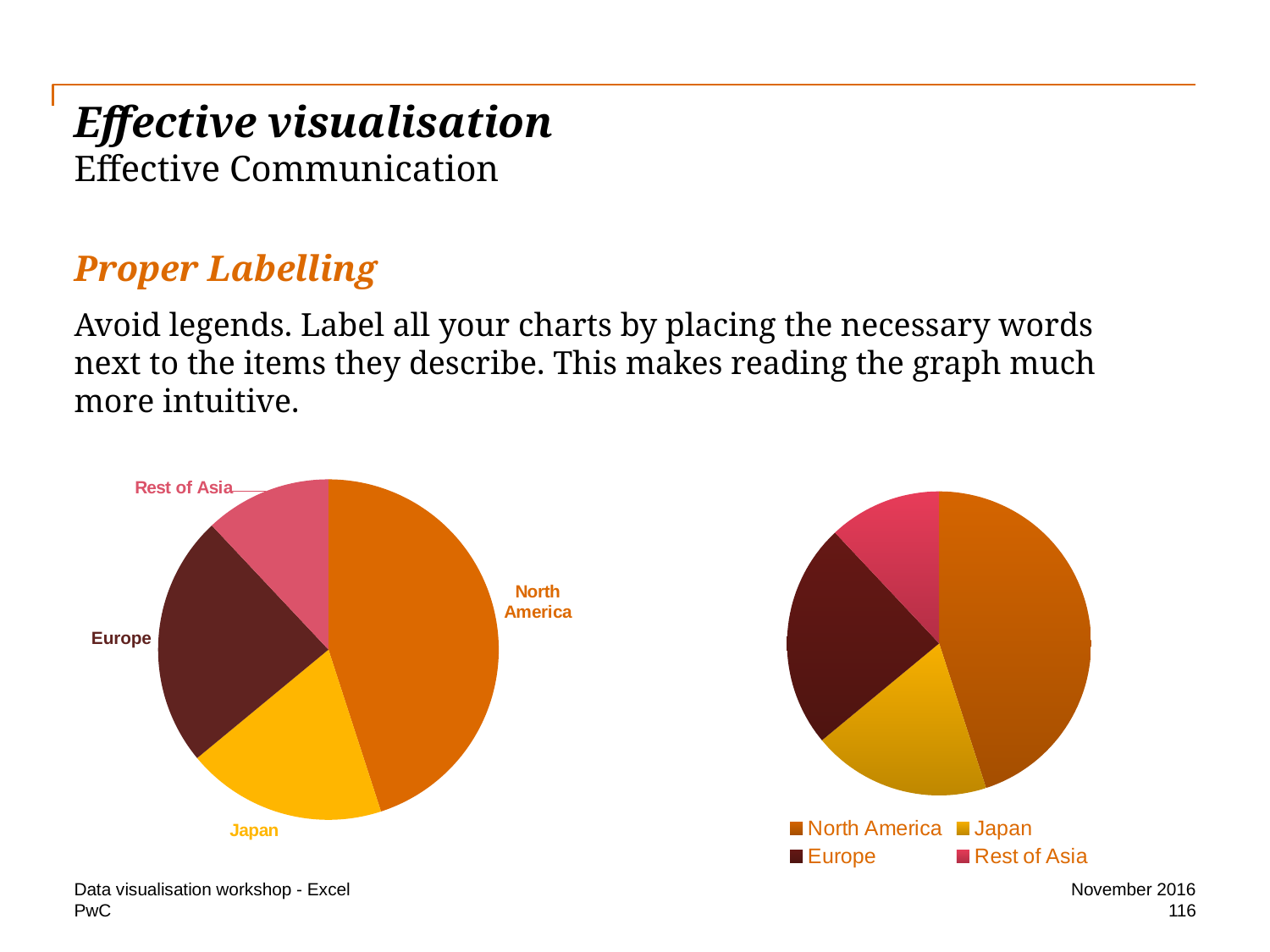
In the left pie chart, how many slices are there? 4 In the right pie chart, how many entries does the legend list? 4 In the right pie chart, which region does the legend associate with the pink colour? Rest of Asia In the left pie chart, which region has the smallest slice? Rest of Asia In the left pie chart, which slice is larger, North America or Japan? North America In the left pie chart, which slice is larger, Europe or Rest of Asia? Europe In the right pie chart, which region has the smallest slice? Rest of Asia What kind of chart is the left chart on the slide? Pie chart What kind of chart is the right chart on the slide? Pie chart Which of the two pie charts uses a legend instead of direct labels? The right chart In the right pie chart, which region has the largest slice? North America In the left pie chart, which region has the largest slice? North America